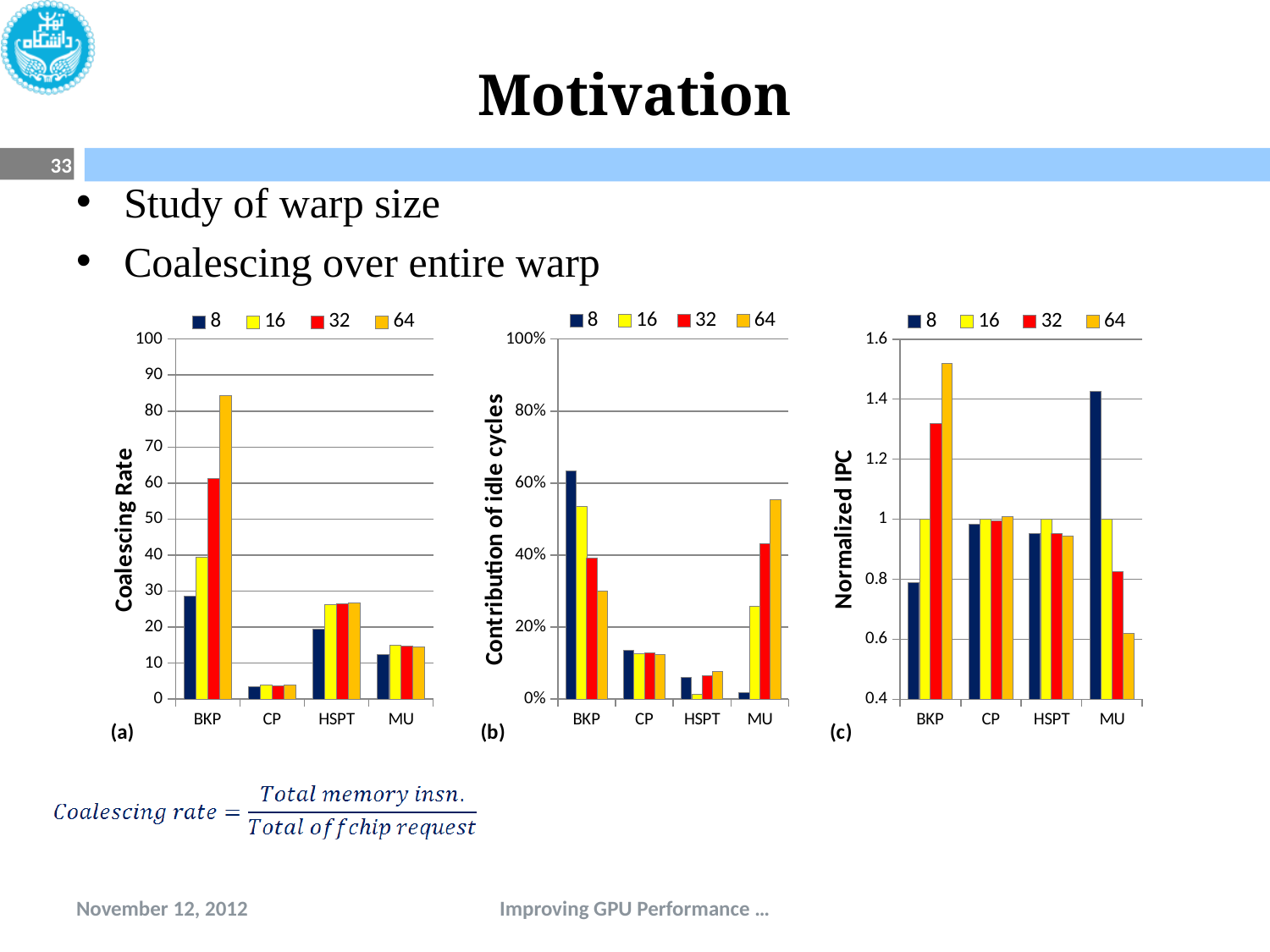
In chart (c), Normalized IPC, is the value for BKP with warp size 64 greater or less than 1.4? greater In chart (b), Contribution of idle cycles, is the value for BKP with warp size 8 greater or less than 60%? greater In chart (a), Coalescing Rate, which category has the highest bar? BKP In chart (b), Contribution of idle cycles, which warp size has the highest value for BKP? 8 In chart (a), Coalescing Rate, which category has the lowest values overall? CP How many categories are shown on the x axis of chart (c), Normalized IPC? 4 In chart (a), Coalescing Rate, is the value for BKP with warp size 64 greater or less than 80? greater What kind of chart is chart (a), Coalescing Rate? bar chart What is the y-axis label of chart (c)? Normalized IPC How many series does the legend of chart (b), Contribution of idle cycles, list? 4 In chart (c), Normalized IPC, which is larger for MU: warp size 8 or warp size 64? warp size 8